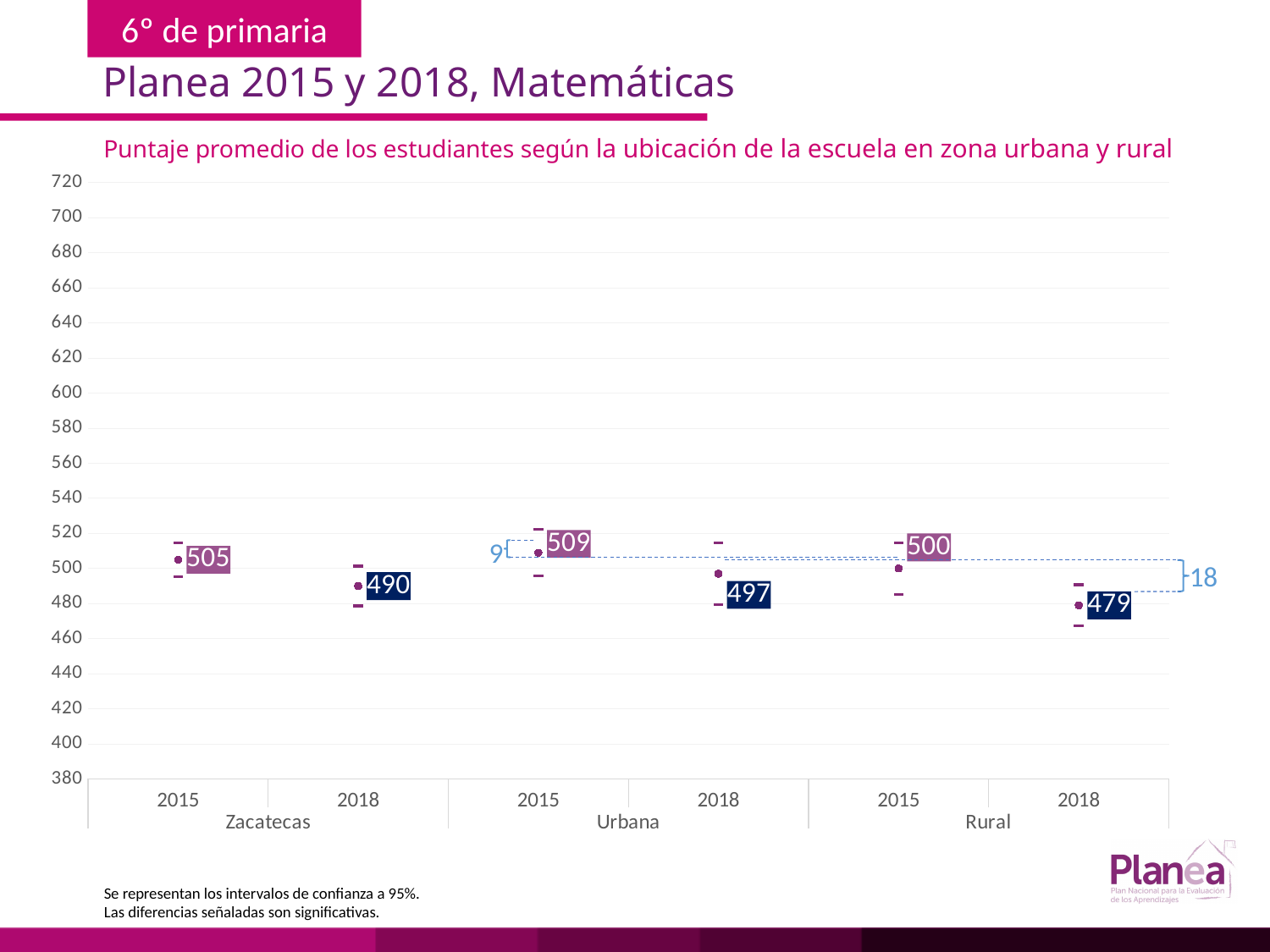
Which is larger, the Rural score in 2015 or the Zacatecas score in 2018? Rural 2015 How many data points are plotted on the chart? 6 What is the average score for Urbana schools in 2015? 509 What is the average score for Zacatecas in 2018? 490 What is the difference between the Zacatecas scores in 2015 and 2018? 15 What is the average score for Zacatecas in 2015? 505 Which group and year has the highest average score? Urbana 2015 What is the difference between the Urbana and Rural average scores in 2018? 18 Which group and year has the lowest average score? Rural 2018 Within each group, do the average scores rise or fall from 2015 to 2018? fall What is the average score for Rural schools in 2018? 479 What is the average score for Urbana schools in 2018? 497